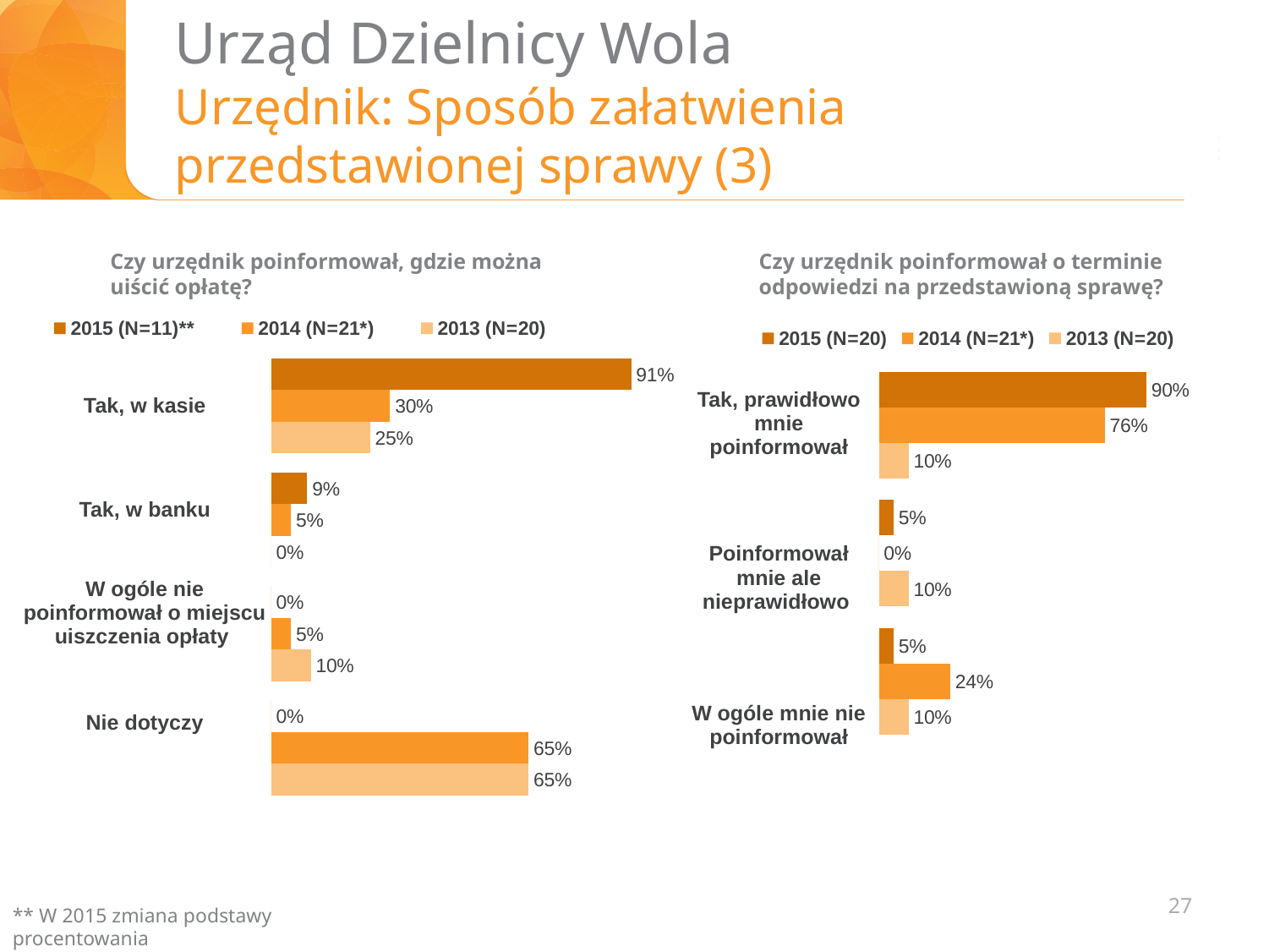
In the right chart (Czy urzędnik poinformował o terminie odpowiedzi na przedstawioną sprawę?), what is the difference between the 2015 and 2013 values for 'Tak, prawidłowo mnie poinformował'? 80 percentage points In the left chart (Czy urzędnik poinformował, gdzie można uiścić opłatę?), what is the difference between the 2015 and 2014 values for 'Tak, w kasie'? 61 percentage points In the right chart (Czy urzędnik poinformował o terminie odpowiedzi na przedstawioną sprawę?), what is the 2014 value for 'W ogóle mnie nie poinformował'? 24% In the left chart (Czy urzędnik poinformował, gdzie można uiścić opłatę?), what is the 2015 value for 'Tak, w kasie'? 91% In the left chart (Czy urzędnik poinformował, gdzie można uiścić opłatę?), how many series does the legend list? 3 In the right chart (Czy urzędnik poinformował o terminie odpowiedzi na przedstawioną sprawę?), what is the sample size (N) shown in the legend for 2015? N=20 In the right chart (Czy urzędnik poinformował o terminie odpowiedzi na przedstawioną sprawę?), what is the 2014 value for 'Tak, prawidłowo mnie poinformował'? 76% What type of chart is the right chart (Czy urzędnik poinformował o terminie odpowiedzi na przedstawioną sprawę?)? Bar chart In the right chart (Czy urzędnik poinformował o terminie odpowiedzi na przedstawioną sprawę?), which is larger for 'W ogóle mnie nie poinformował': the 2014 value or the 2013 value? 2014 In the left chart (Czy urzędnik poinformował, gdzie można uiścić opłatę?), how many categories are shown? 4 In the left chart (Czy urzędnik poinformował, gdzie można uiścić opłatę?), what is the 2014 value for 'Nie dotyczy'? 65% In the left chart (Czy urzędnik poinformował, gdzie można uiścić opłatę?), which category has the highest 2015 value? Tak, w kasie